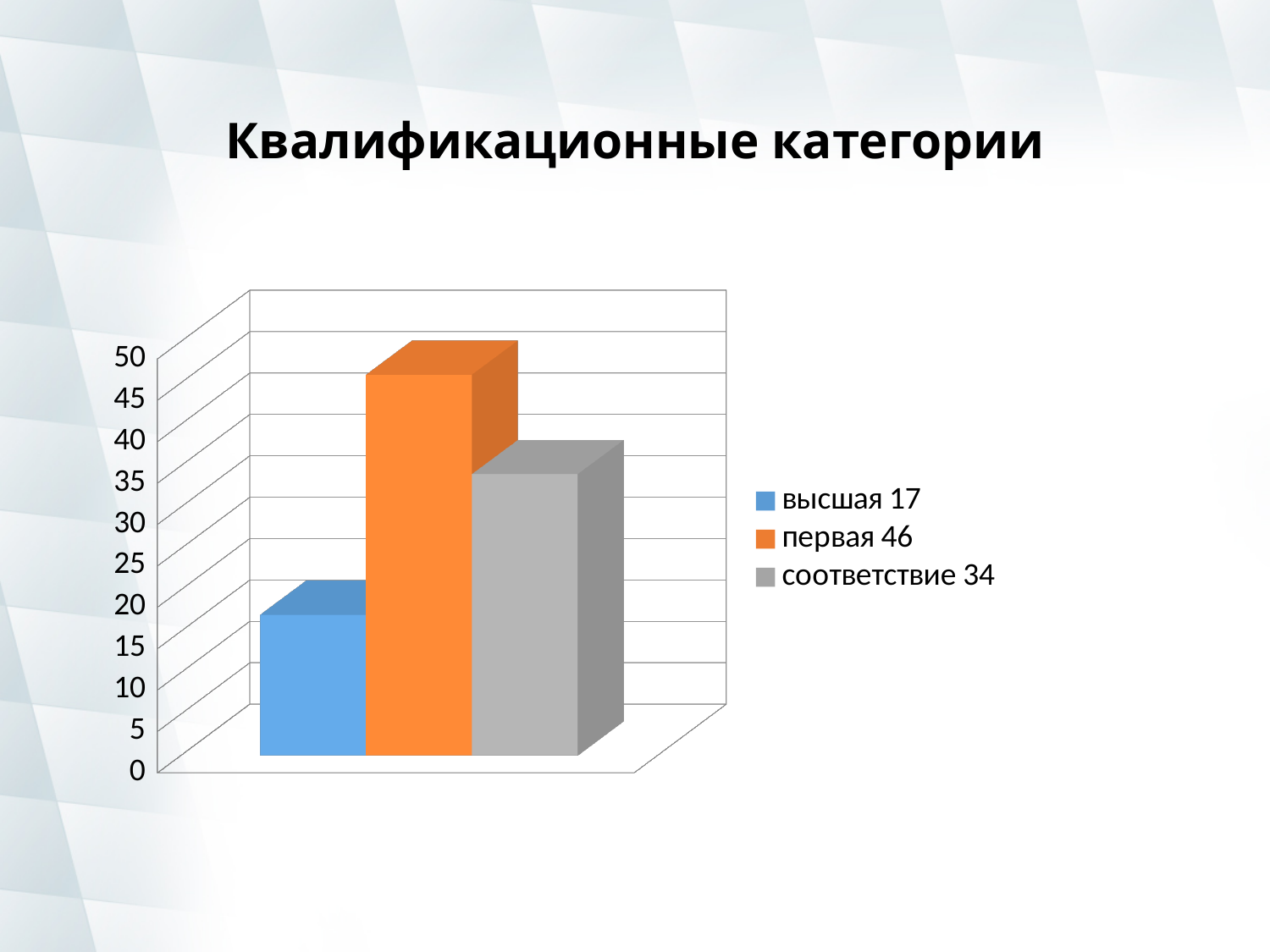
Which category has the highest value? первая What is the value for высшая? 17 Which category has the lowest value? высшая How many series does the legend list? 3 Which is larger, the value for высшая or the value for соответствие? соответствие What is the title of the chart? Квалификационные категории What kind of chart is shown on the slide? bar chart What is the difference between the values for соответствие and высшая? 17 Is the value for первая greater or less than 40? greater What is the value for соответствие? 34 What is the value for первая? 46 What is the difference between the values for первая and соответствие? 12